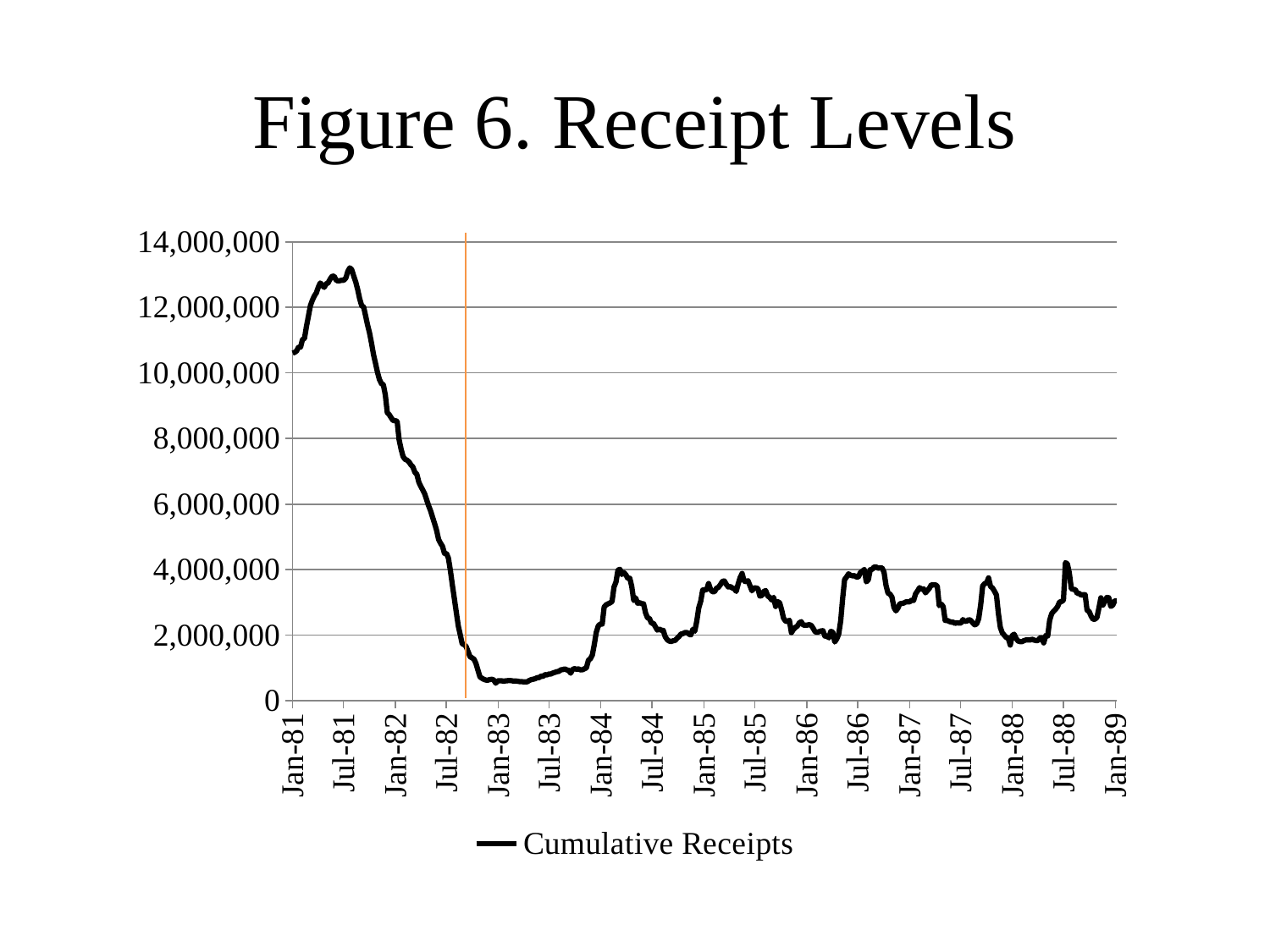
Do the Cumulative Receipts values rise or fall between Jul-81 and Jan-83? fall Is the value for Cumulative Receipts at Jan-89 greater or less than 4,000,000? less In which year does the Cumulative Receipts line reach its highest point? 1981 How many series does the legend list? 1 In which year does the Cumulative Receipts line reach its lowest point? 1983 Is the value for Cumulative Receipts at Jul-81 greater or less than 12,000,000? greater What kind of chart is shown on the slide? line chart What is the name of the series shown in the legend? Cumulative Receipts Is the value for Cumulative Receipts at Jan-81 greater or less than 10,000,000? greater What is the title of the chart? Figure 6. Receipt Levels